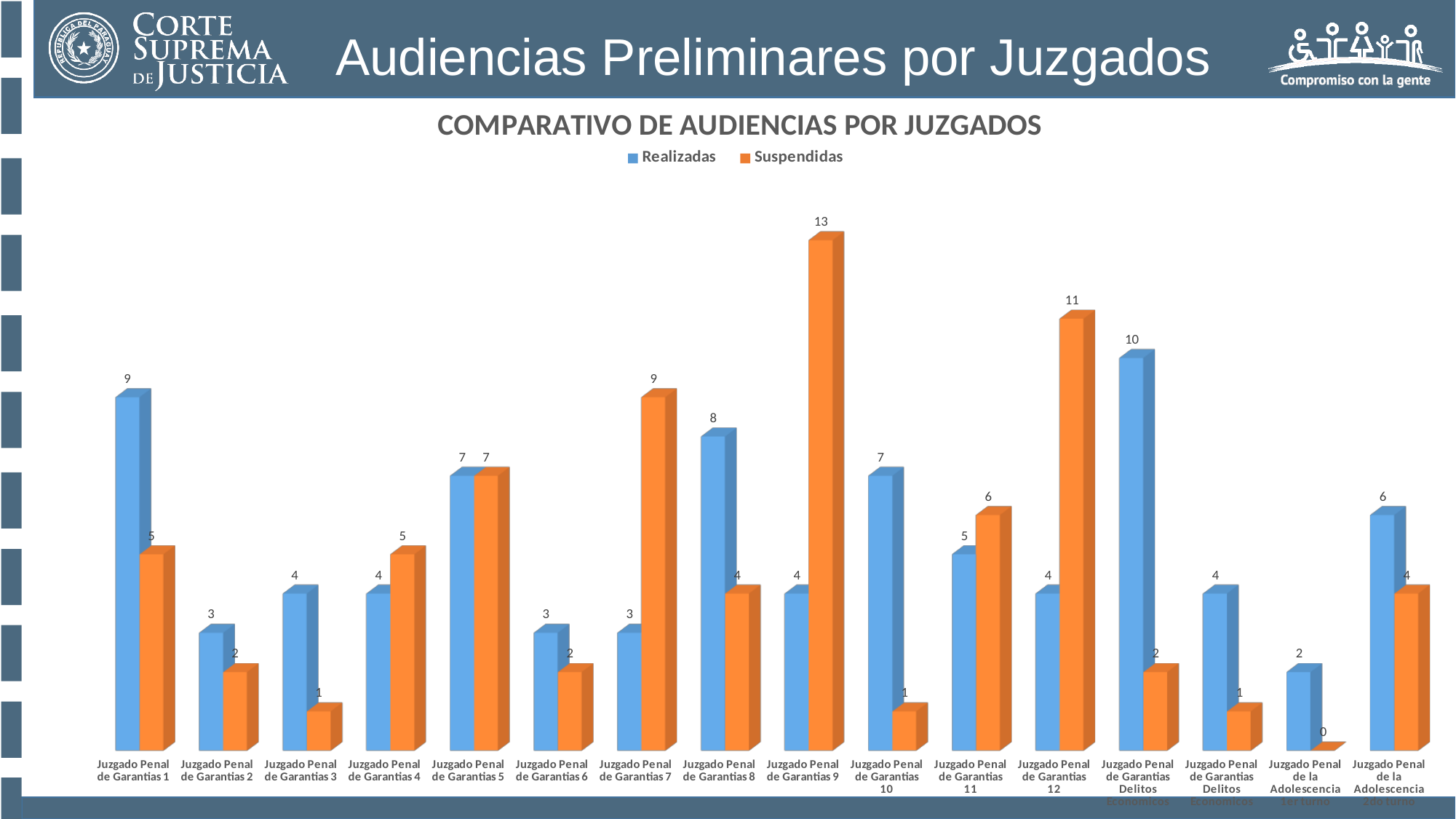
How many juzgados (categories) are shown on the x axis? 16 Which has the larger Realizadas value: Juzgado Penal de Garantias 10 or Juzgado Penal de Garantias 11? Juzgado Penal de Garantias 10 What is the Realizadas value for Juzgado Penal de Garantias 10? 7 For Juzgado Penal de Garantias 9, what is the difference between Suspendidas and Realizadas? 9 What is the Suspendidas value for Juzgado Penal de Garantias 7? 9 Which juzgado has the highest Suspendidas value? Juzgado Penal de Garantias 9 What kind of chart is shown on the slide? Bar chart What is the title of the chart? COMPARATIVO DE AUDIENCIAS POR JUZGADOS For Juzgado Penal de Garantias 8, which is larger: Realizadas or Suspendidas? Realizadas What is the Suspendidas value for Juzgado Penal de Garantias 12? 11 How many series does the legend list? 2 What is the Realizadas value for Juzgado Penal de Garantias 1? 9